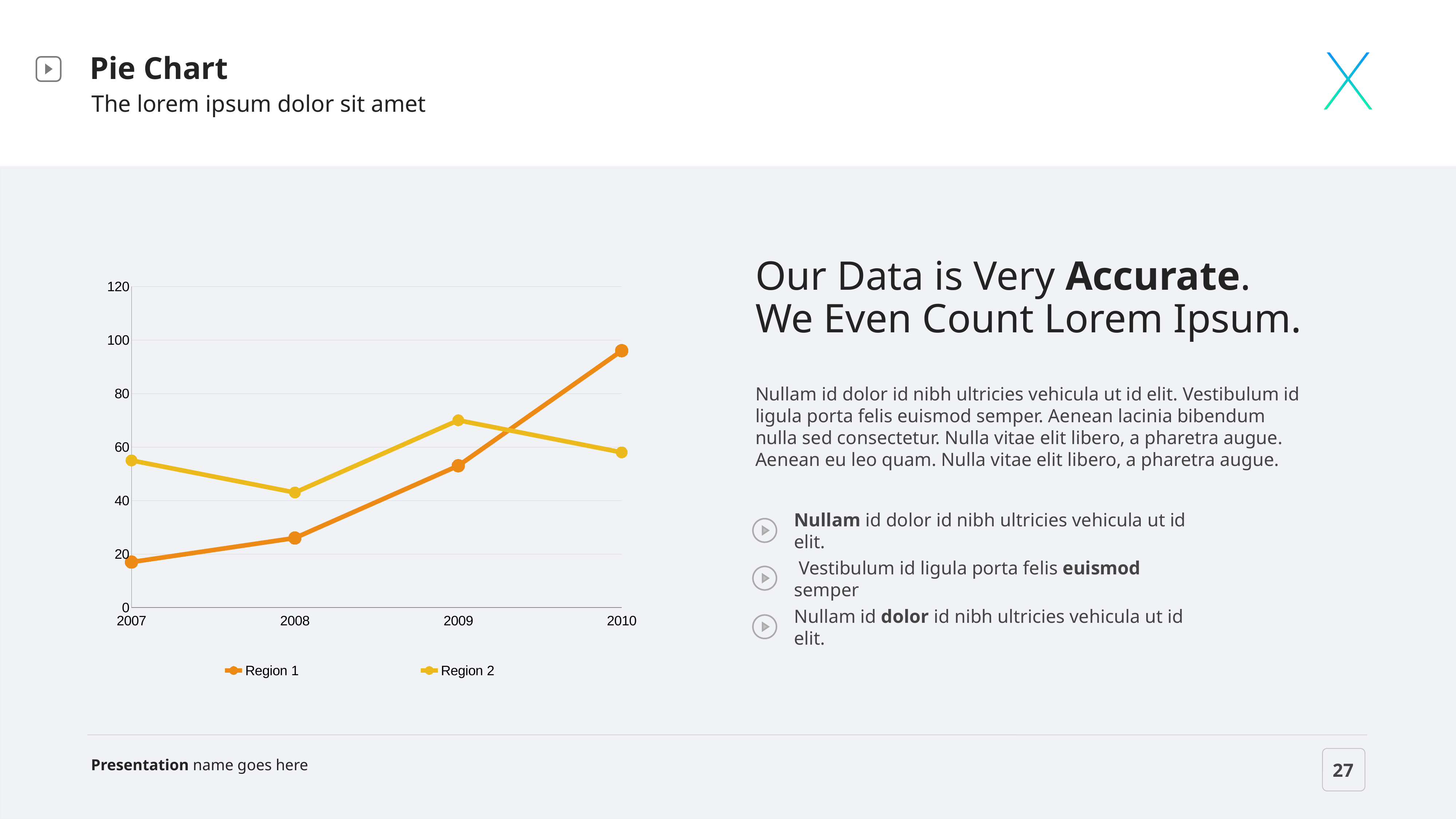
Does the Region 1 line rise or fall from 2007 to 2010? Rises In which year does Region 2 reach its highest value? 2009 In 2010, which series has the larger value, Region 1 or Region 2? Region 1 In which year is Region 1 at its lowest value? 2007 In which year is Region 2 at its lowest value? 2008 In which year does Region 1 reach its highest value? 2010 How many years are shown on the x axis of the chart? 4 How many series does the chart legend list? 2 Is the value for Region 2 in 2008 greater or less than 60? less Is the value for Region 1 in 2010 greater or less than 80? greater What kind of chart is shown on the slide? Line chart In 2007, which series has the larger value, Region 1 or Region 2? Region 2